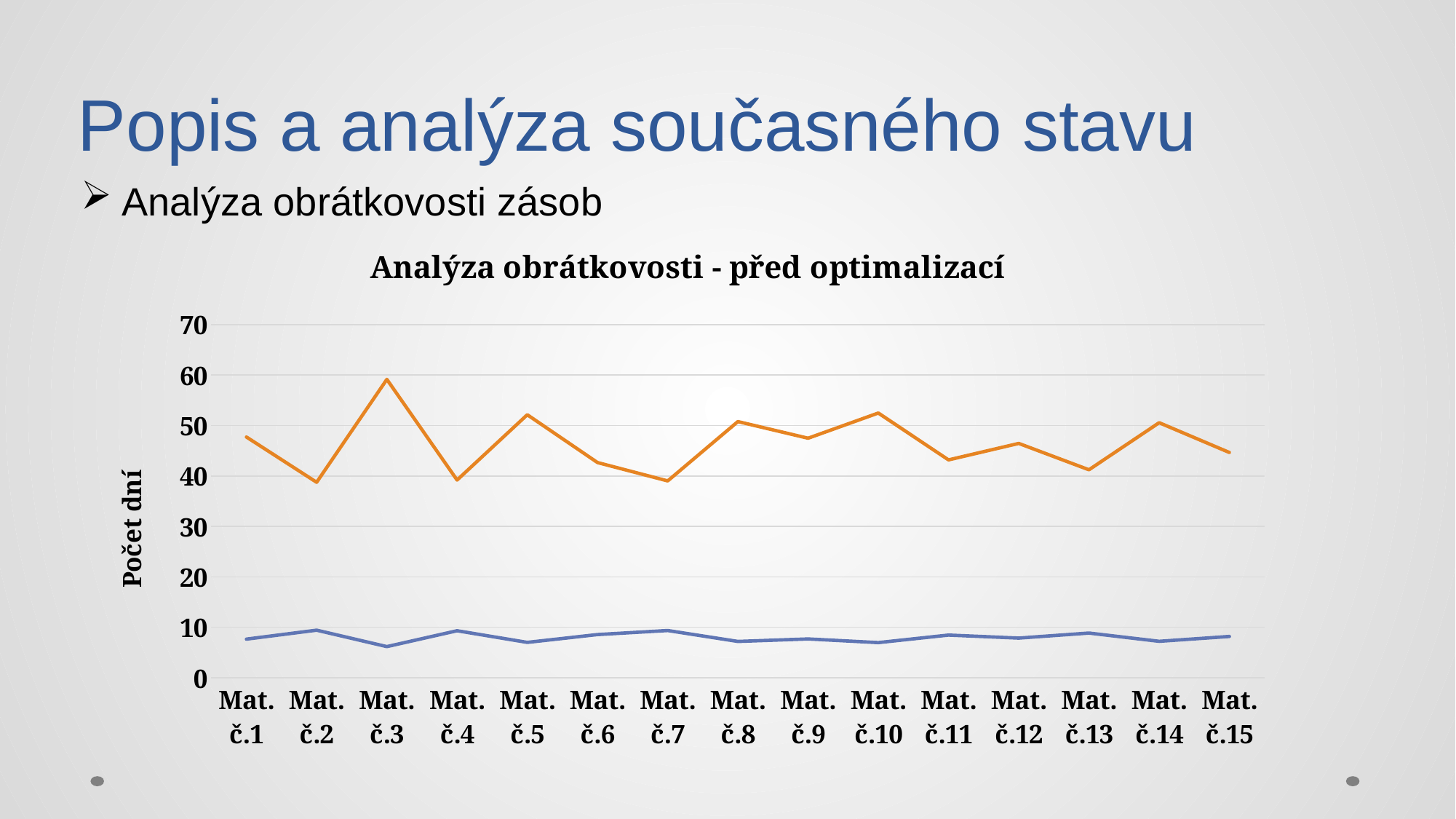
Is the value of the orange line for Mat. č.13 greater or less than 50? less Does the orange line rise or fall from Mat. č.3 to Mat. č.4? fall At which category does the orange line reach its highest value? Mat. č.3 How many lines are plotted on the chart? 2 What kind of chart is shown on the slide? line chart How many categories (materials) are shown on the x axis? 15 What is the title of the chart? Analýza obrátkovosti - před optimalizací Which is larger for the orange line: the value for Mat. č.3 or the value for Mat. č.4? Mat. č.3 Is the value of the blue line for Mat. č.3 greater or less than 10? less At Mat. č.8, which line has the higher value, the orange line or the blue line? the orange line Is the value of the orange line for Mat. č.3 greater or less than 50? greater What is the label on the vertical axis of the chart? Počet dní